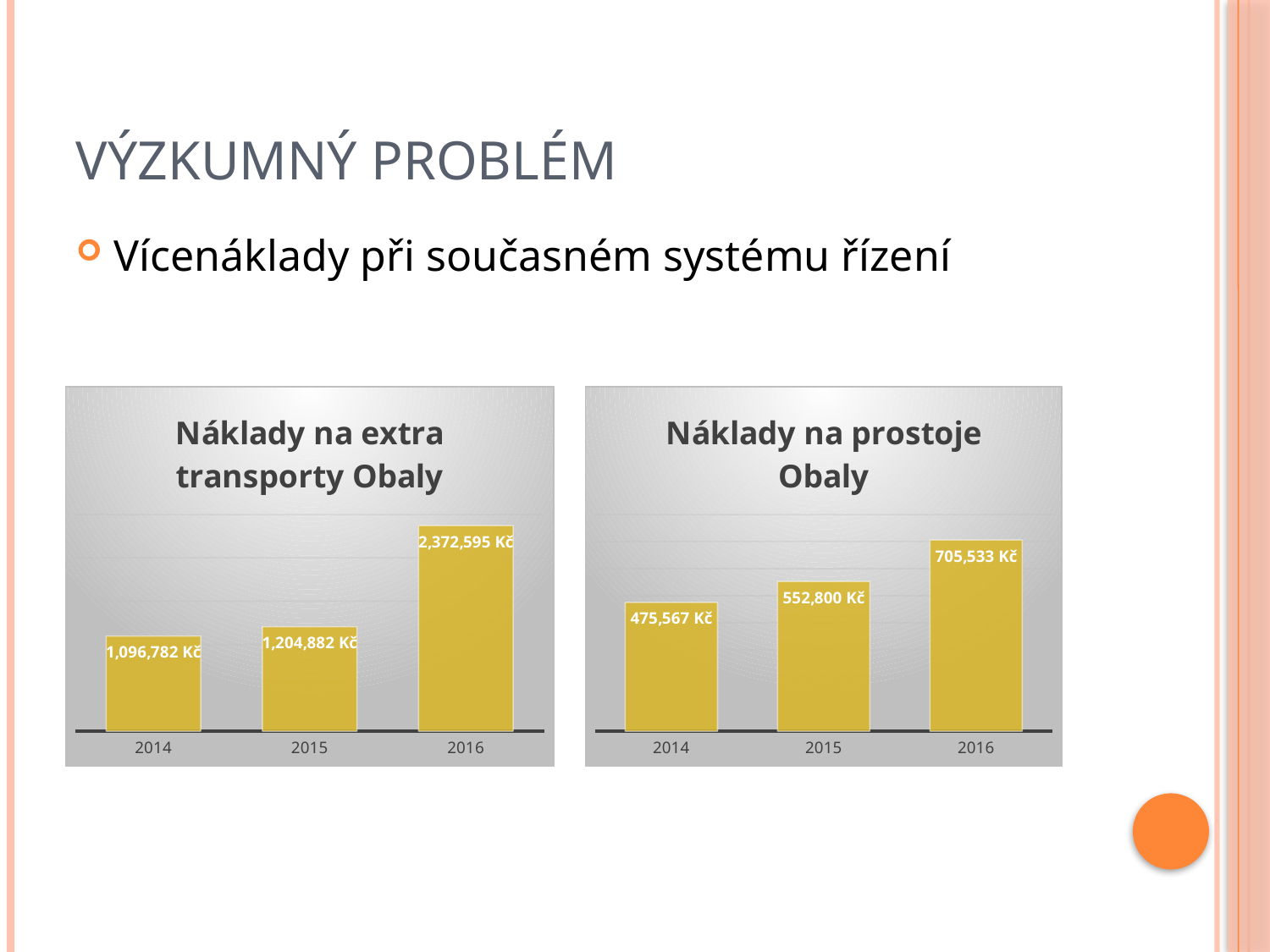
In the chart titled "Náklady na prostoje Obaly", which year has the lowest value? 2014 In the chart titled "Náklady na prostoje Obaly", what is the value for 2014? 475,567 Kč In the chart titled "Náklady na prostoje Obaly", do the values rise or fall from 2014 to 2016? Rise In the chart titled "Náklady na prostoje Obaly", what is the difference between the values for 2016 and 2014? 229,966 Kč In the chart titled "Náklady na extra transporty Obaly", which is larger, the value for 2014 or the value for 2015? 2015 How many years are shown on the x axis of the chart titled "Náklady na prostoje Obaly"? 3 In the chart titled "Náklady na extra transporty Obaly", what is the value for 2016? 2,372,595 Kč In the chart titled "Náklady na extra transporty Obaly", which year has the highest value? 2016 In the chart titled "Náklady na extra transporty Obaly", what is the value for 2014? 1,096,782 Kč What kind of chart is the chart titled "Náklady na extra transporty Obaly"? Bar chart In the chart titled "Náklady na extra transporty Obaly", what is the difference between the values for 2016 and 2015? 1,167,713 Kč In the chart titled "Náklady na prostoje Obaly", what is the value for 2015? 552,800 Kč